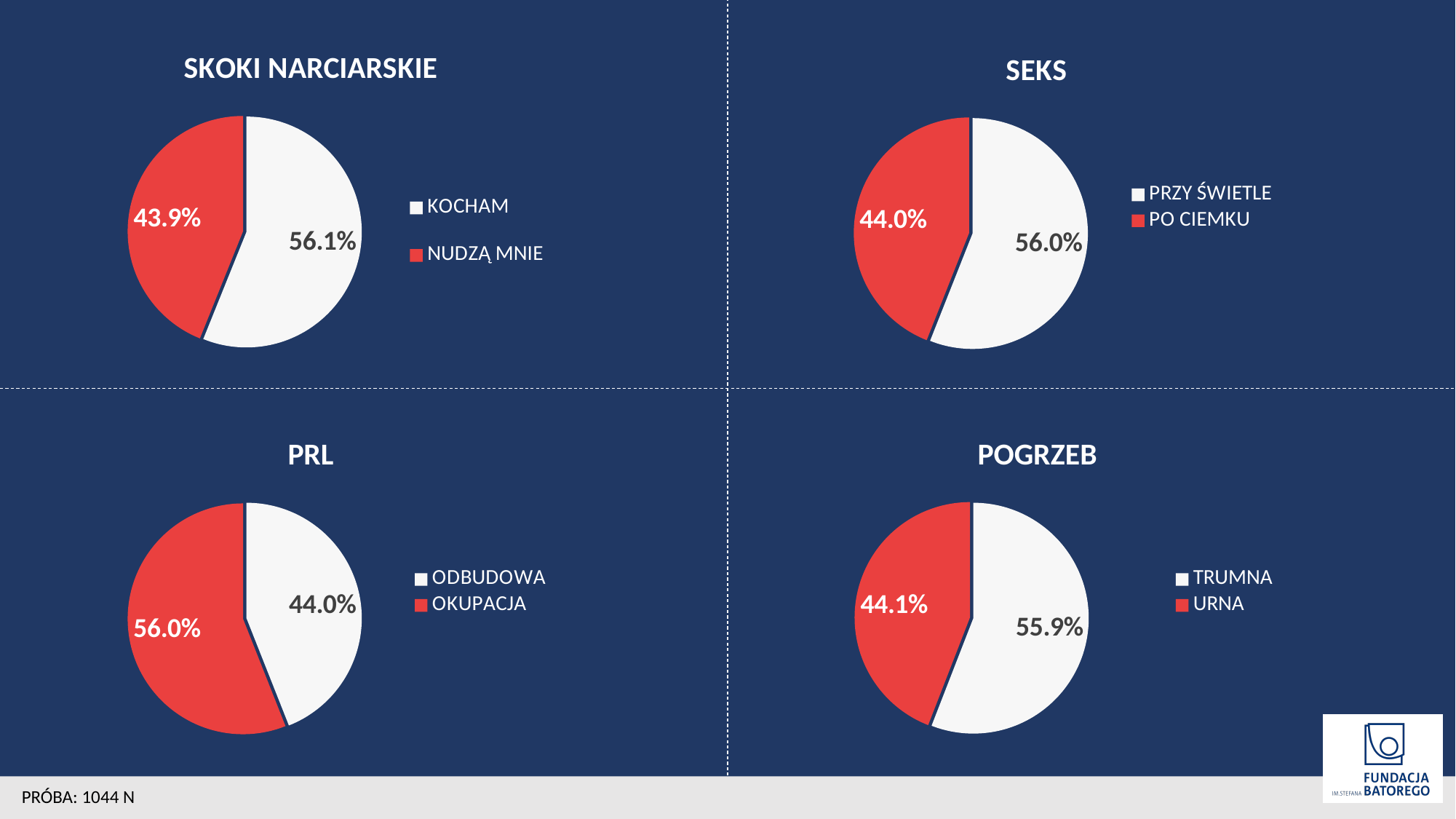
In the SEKS chart, which category has the largest share? PRZY ŚWIETLE In the PRL chart, which slice is larger, ODBUDOWA or OKUPACJA? OKUPACJA In the SEKS chart, which colour represents PO CIEMKU? Red In the SEKS chart, what is the value for PO CIEMKU? 44.0% In the POGRZEB chart, which category has the smallest share? URNA In the SKOKI NARCIARSKIE chart, what is the difference between the KOCHAM and NUDZĄ MNIE shares? 12.2% In the SKOKI NARCIARSKIE chart, what share is labelled NUDZĄ MNIE? 43.9% In the SKOKI NARCIARSKIE chart, what share is labelled KOCHAM? 56.1% In the POGRZEB chart, what is the value for TRUMNA? 55.9% How many slices does the POGRZEB pie chart have? 2 What type of chart is used in the PRL panel? Pie chart In the PRL chart, what is the value for OKUPACJA? 56.0%